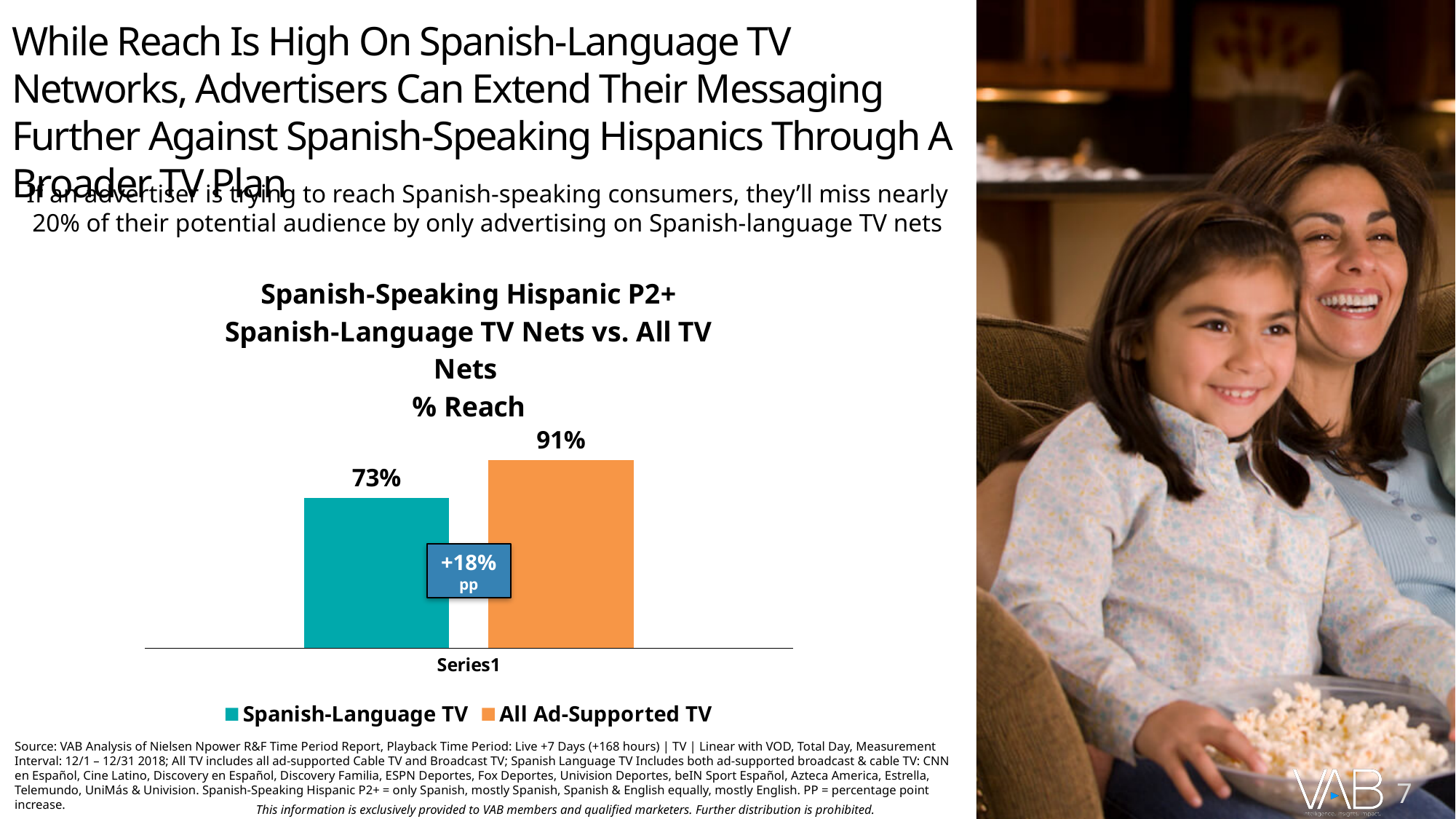
What is the category label shown on the x axis? Series1 What colour is the bar for All Ad-Supported TV? orange What is the % reach for Spanish-Language TV? 73% What kind of chart is shown on the slide? bar chart Is the % reach for Spanish-Language TV larger or smaller than that for All Ad-Supported TV? smaller What is the % reach for All Ad-Supported TV? 91% What is the title of the chart? Spanish-Speaking Hispanic P2+ Spanish-Language TV Nets vs. All TV Nets % Reach Which series has the lower % reach? Spanish-Language TV What is the difference in % reach between All Ad-Supported TV and Spanish-Language TV? 18% pp Which series has the higher % reach? All Ad-Supported TV How many series does the legend list? 2